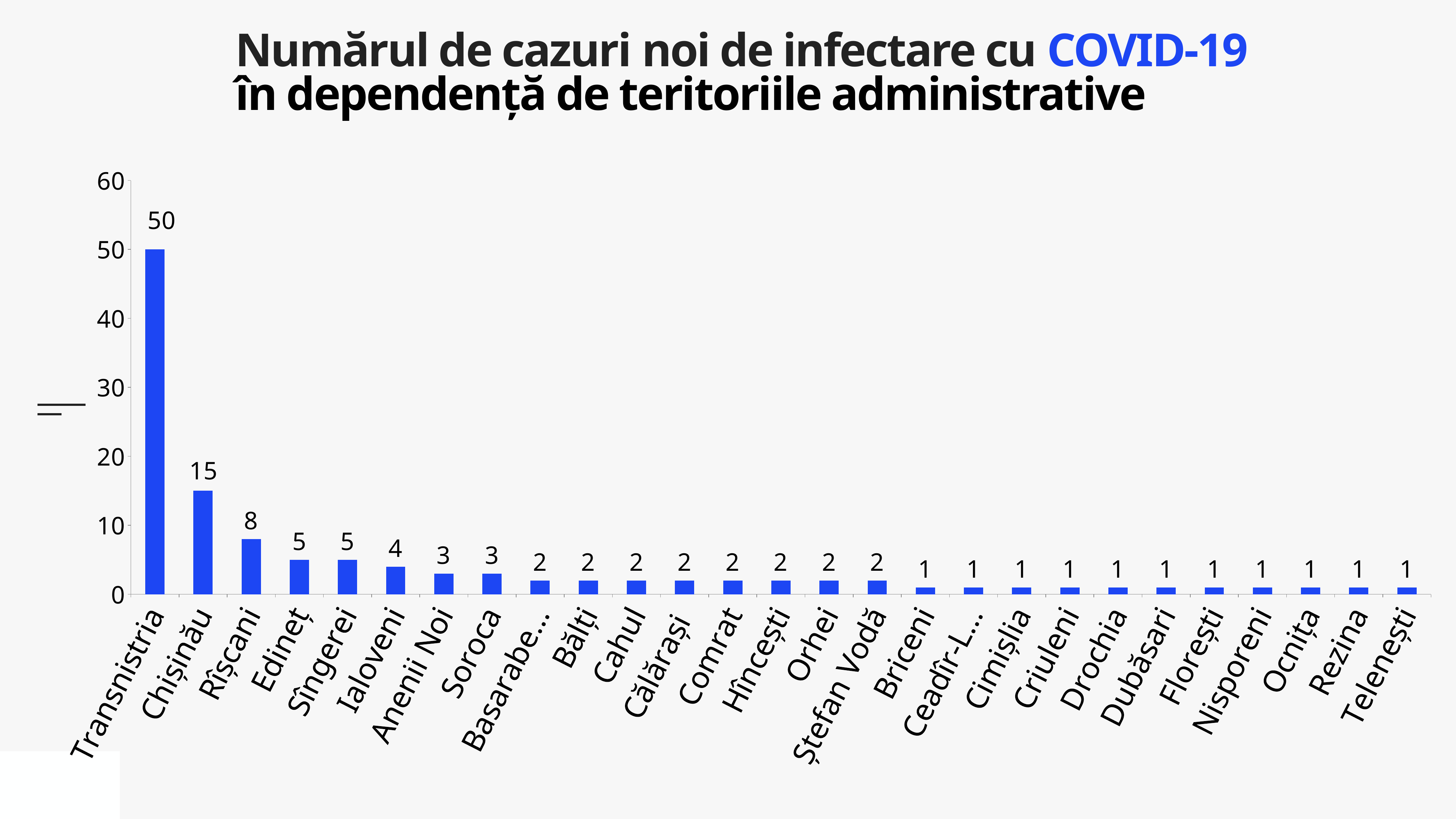
Which is larger, the value for Chișinău or the value for Rîșcani? Chișinău What is the difference between the values for Rîșcani and Edineț? 3 Which territory has the highest number of new cases? Transnistria What is the difference between the values for Transnistria and Chișinău? 35 What is the value for Chișinău? 15 What kind of chart is shown on the slide? bar chart What is the value for Ialoveni? 4 Is the value for Transnistria greater or less than 40? greater What is the value for Rîșcani? 8 What is the value for Transnistria? 50 How many territories are shown on the x axis? 27 What is the value for Soroca? 3